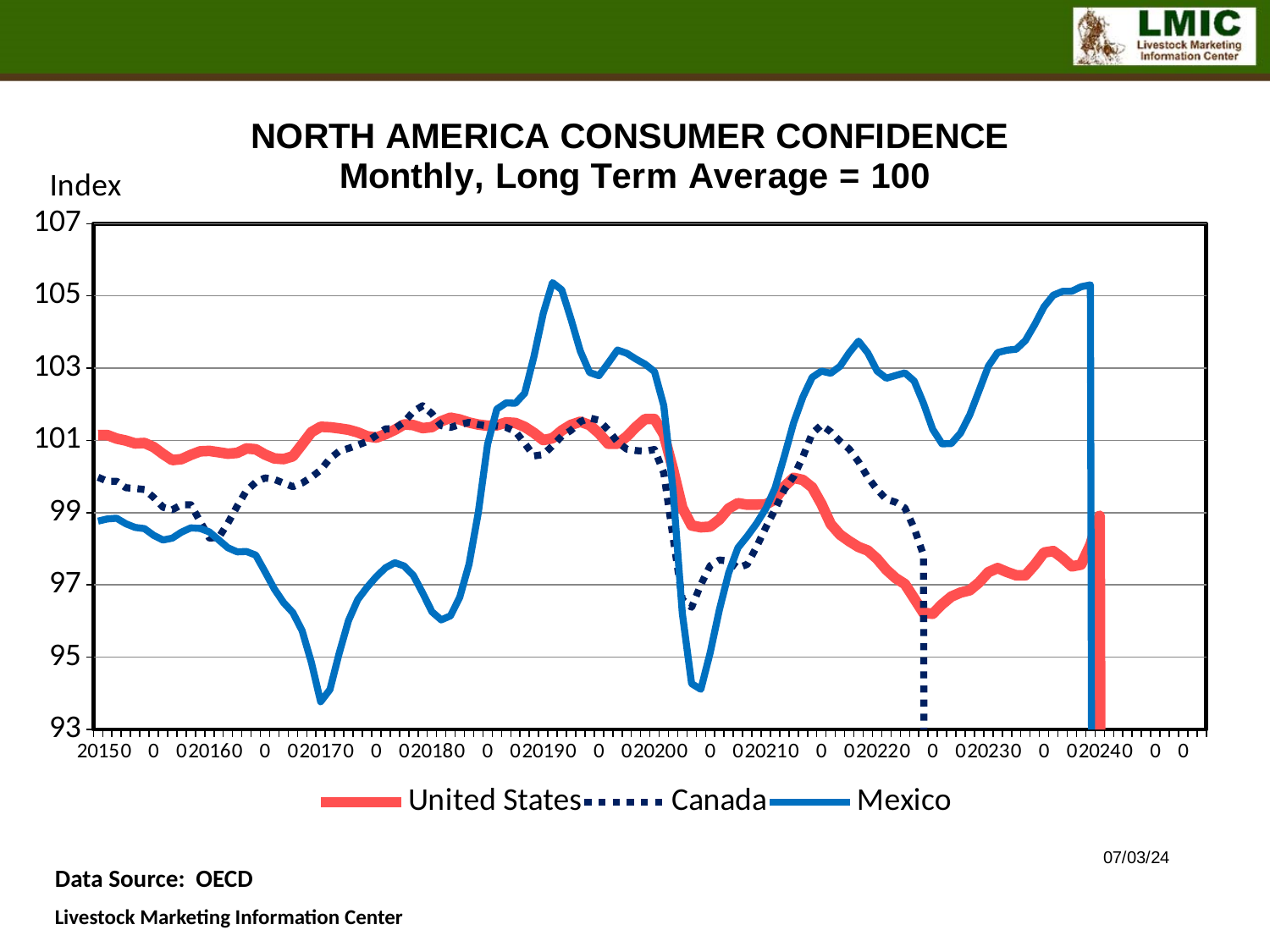
Is the lowest value of the Mexico line in 2017 greater or less than 95? less What kind of chart is shown on the slide? line chart In 2017, which is higher, the United States line or the Mexico line? United States Which series reaches the highest value anywhere on the chart? Mexico Is the Mexico line's dip in 2018 greater or less than 97? less How many series does the legend list? 3 Which series are listed in the legend? United States, Canada, Mexico What is the label on the vertical axis? Index In 2023, which is higher, the Mexico line or the United States line? Mexico Is the lowest value of the United States line in 2022 greater or less than 97? less